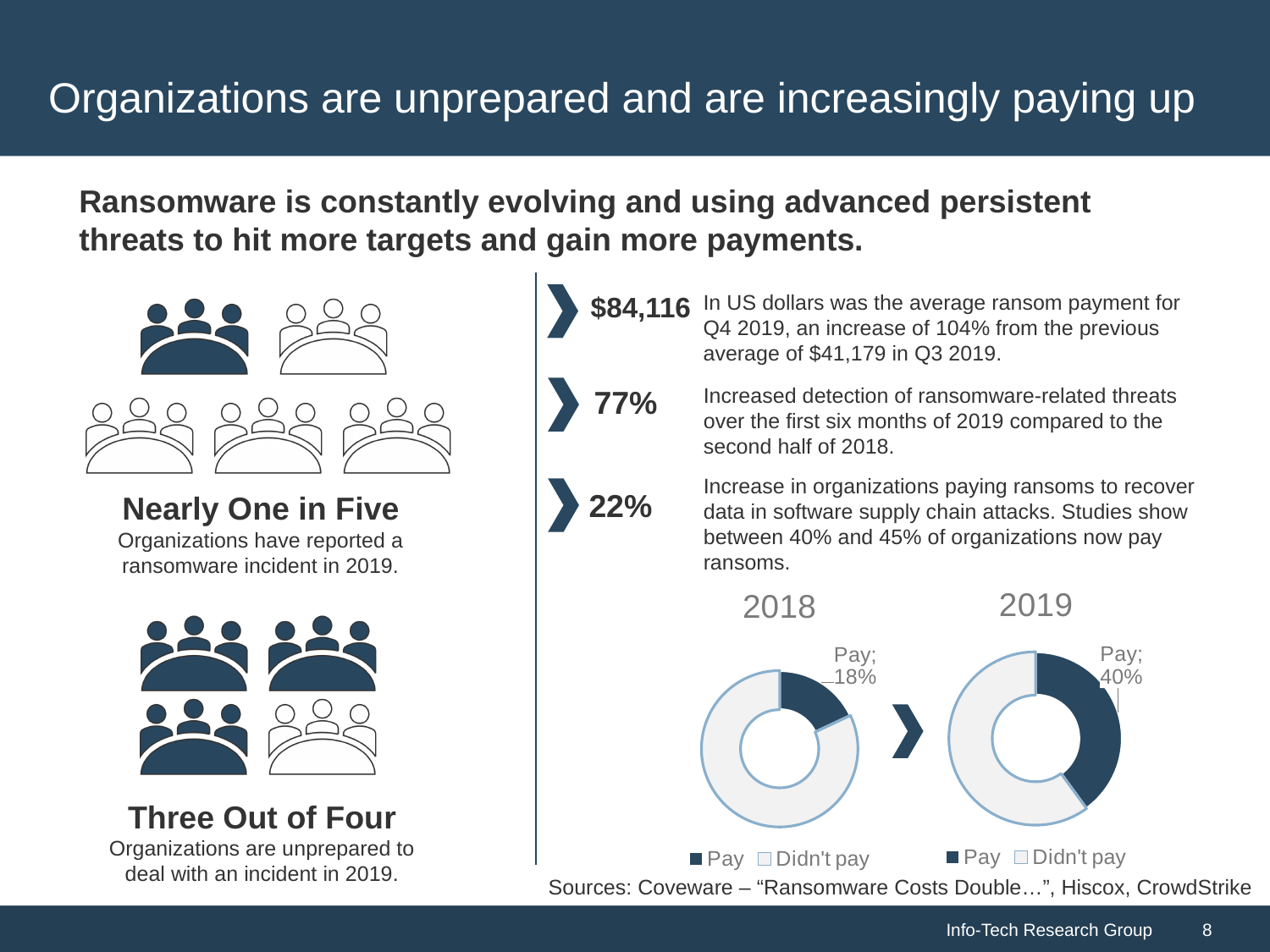
In the 2018 donut chart, which slice is larger: Pay or Didn't pay? Didn't pay By how many percentage points did the Pay share increase from the 2018 chart to the 2019 chart? 22 percentage points Does the Pay share rise or fall from the 2018 chart to the 2019 chart? Rise How many donut charts are shown on the slide? 2 Which colour represents the Pay slice in the donut charts? Dark blue In the 2018 donut chart, what share of organizations paid the ransom? 18% What type of chart is used to show the 2018 and 2019 Pay versus Didn't pay data? Donut (pie) chart In the 2019 donut chart, which slice is larger: Pay or Didn't pay? Didn't pay What are the two legend entries of the 2018 donut chart? Pay, Didn't pay How many series does the legend of the 2019 donut chart list? 2 Which is larger: the Pay share in the 2018 chart or the Pay share in the 2019 chart? 2019 In the 2019 donut chart, what share of organizations paid the ransom? 40%